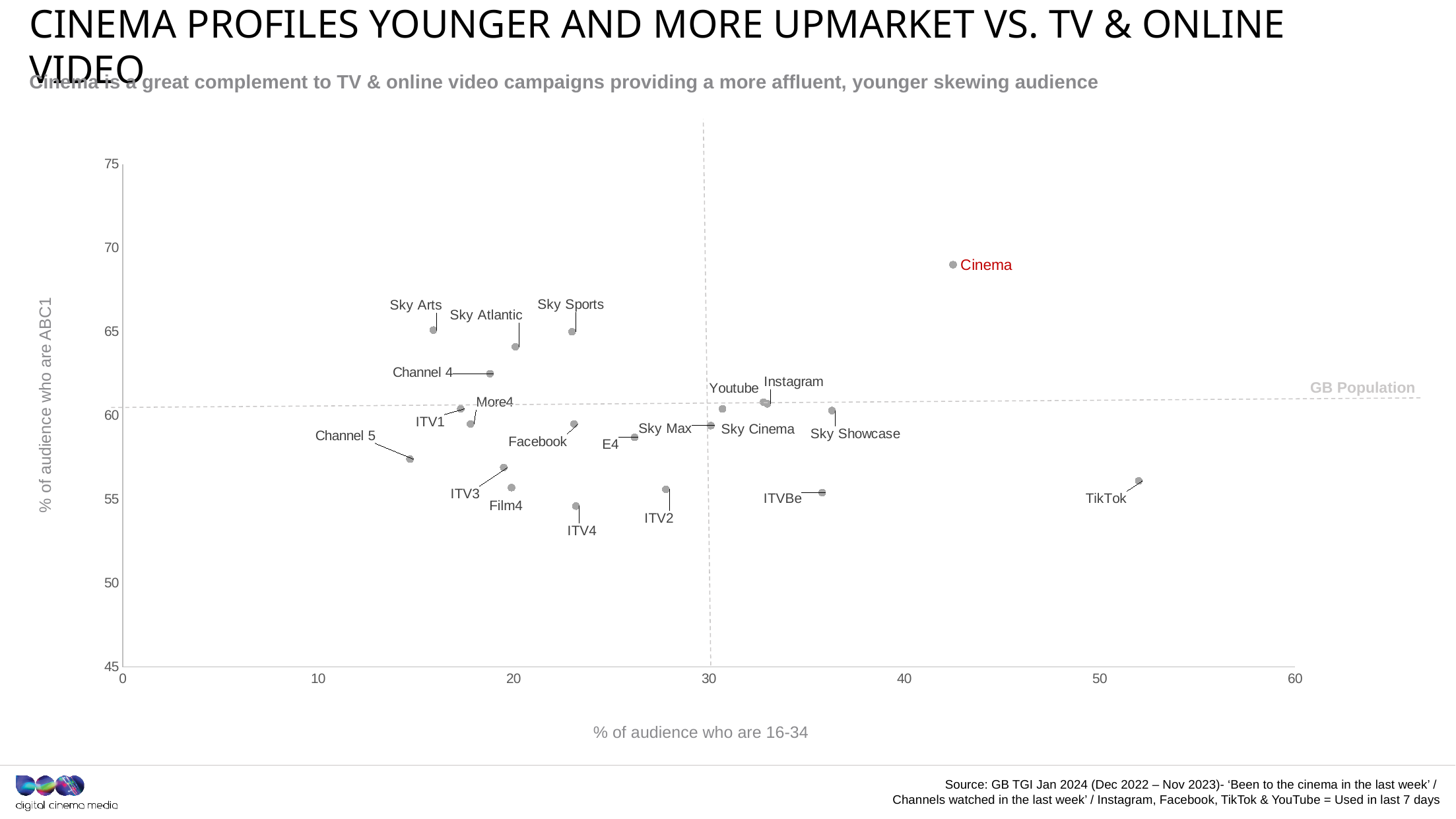
Is the % of audience who are ABC1 for Cinema greater or less than 65? greater What label is given to the horizontal dashed reference line? GB Population Is the % of audience who are 16-34 for Cinema greater or less than 40? greater Is the % of audience who are 16-34 for TikTok greater or less than 50? greater Which point has the lowest % of audience who are 16-34? Channel 5 Which point has the highest % of audience who are 16-34? TikTok Which has a higher % of audience who are ABC1, Cinema or TikTok? Cinema Which point has the highest % of audience who are ABC1? Cinema Which point is highlighted in red on the chart? Cinema What kind of chart is shown on the slide? scatter chart